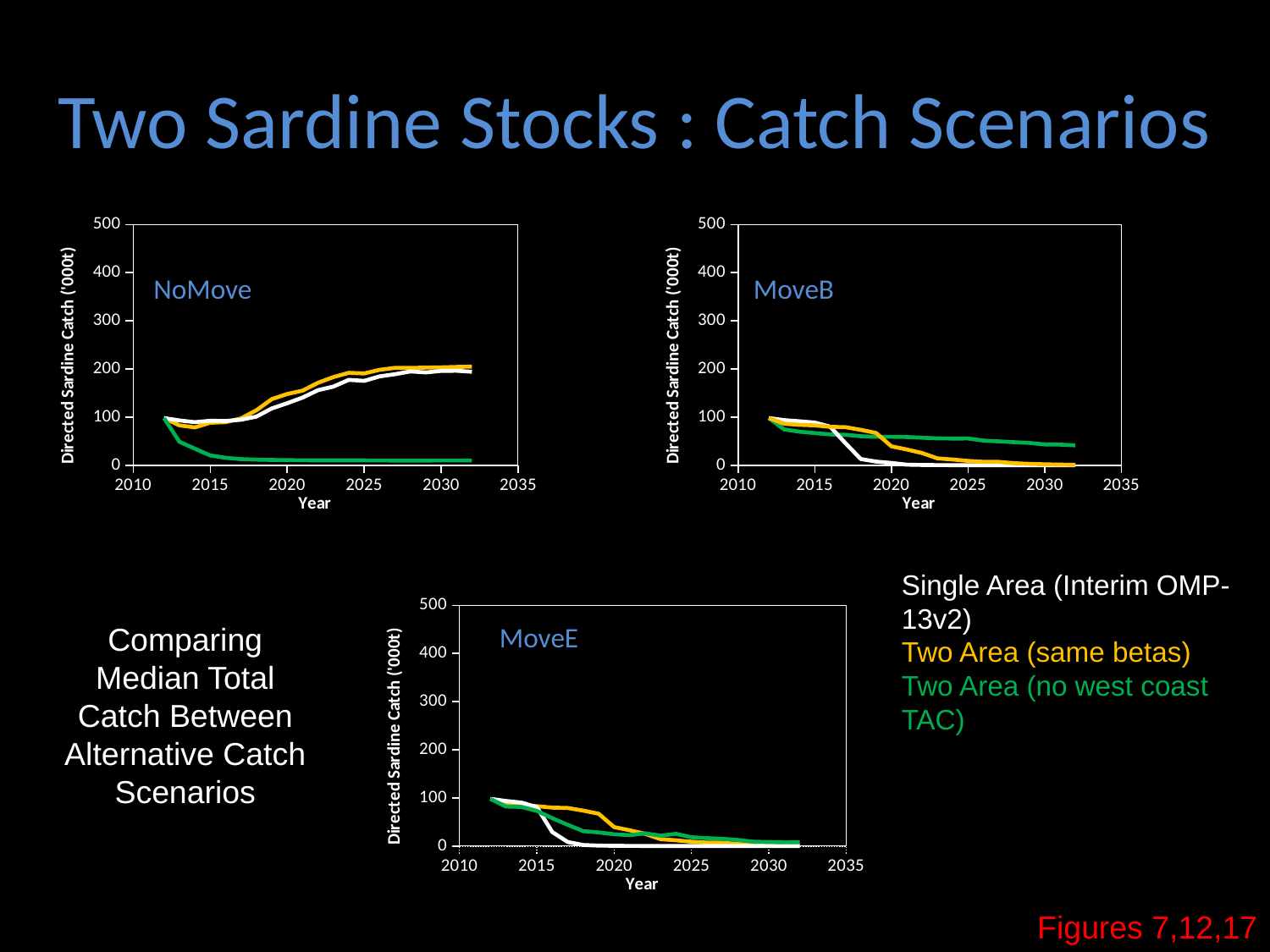
What kind of chart is the NoMove chart? line chart How many catch scenarios (series) does the legend on the right list? 3 In the NoMove chart, does the green 'Two Area (no west coast TAC)' line rise or fall from 2012 to 2032? fall In the NoMove chart, is the value of the green 'Two Area (no west coast TAC)' line in 2030 greater or less than 100? less In the MoveB chart, which line is higher in 2030: the green 'Two Area (no west coast TAC)' line or the white 'Single Area' line? green 'Two Area (no west coast TAC)' In the MoveE chart, is the value of the yellow 'Two Area (same betas)' line in 2030 greater or less than 100? less In the MoveB chart, does the white 'Single Area' line rise or fall from 2012 to 2032? fall What is the y-axis label on the MoveE chart? Directed Sardine Catch ('000t) How many charts are shown on the slide? 3 Which colour represents the 'Single Area (Interim OMP-13v2)' scenario in the charts? white In the NoMove chart, does the yellow 'Two Area (same betas)' line rise or fall from 2012 to 2032? rise In the NoMove chart, is the value of the yellow 'Two Area (same betas)' line in 2030 greater or less than 100? greater